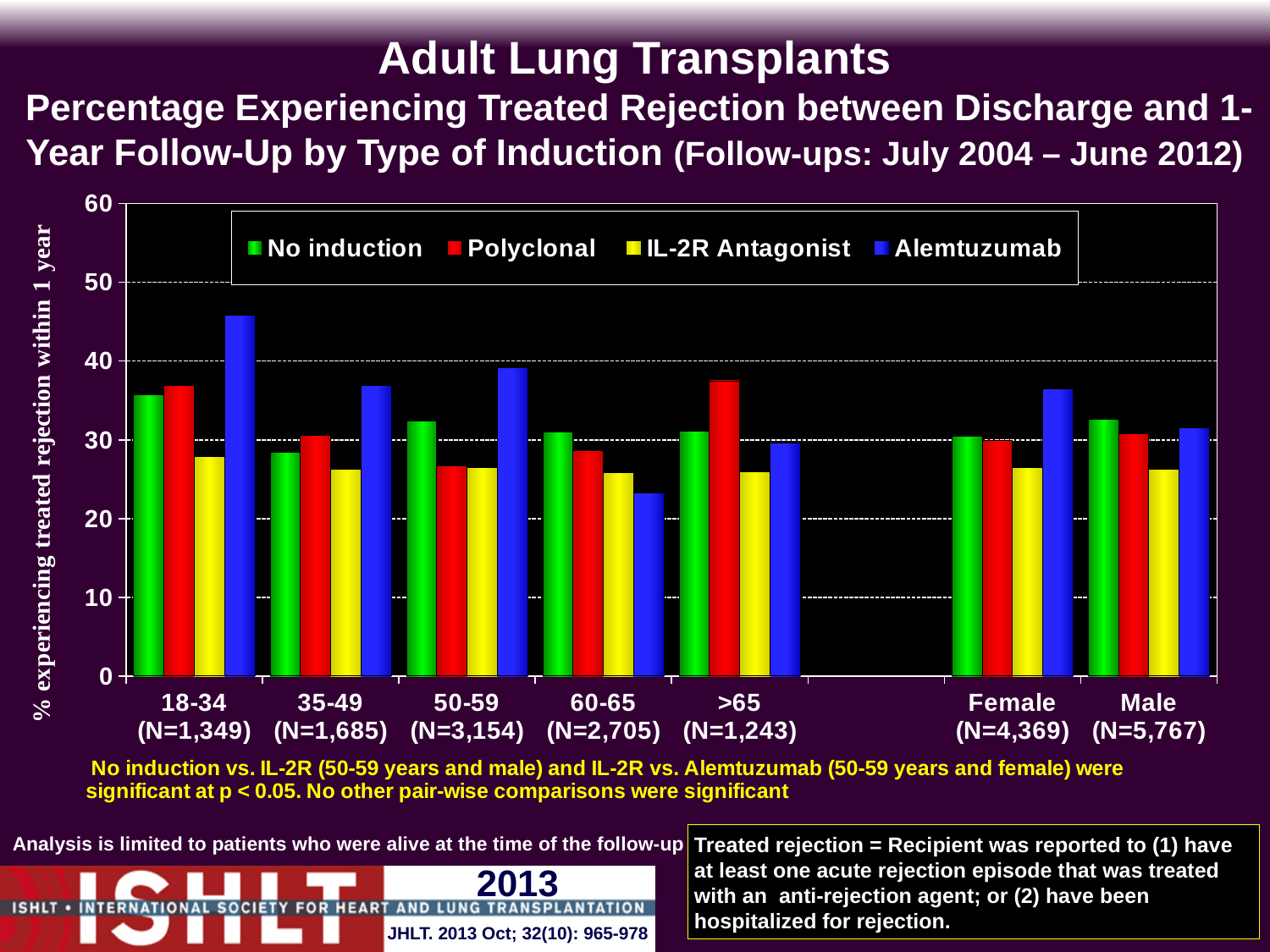
What kind of chart is shown on the slide? bar chart Is the value for Alemtuzumab in the 18-34 age group greater or less than 40? greater How many series does the legend list? 4 Which single bar is the highest on the whole chart? Alemtuzumab, 18-34 What colour represents Polyclonal in the legend? red Is the value for Alemtuzumab in the 60-65 age group greater or less than 30? less Which induction type has the highest value in the 18-34 age group? Alemtuzumab In the 50-59 age group, which is larger: Alemtuzumab or No induction? Alemtuzumab In the >65 age group, which is larger: Polyclonal or No induction? Polyclonal How many categories are shown along the x axis? 7 Is the value for IL-2R Antagonist in the 18-34 age group greater or less than 30? less Which induction type has the lowest value in the 60-65 age group? Alemtuzumab